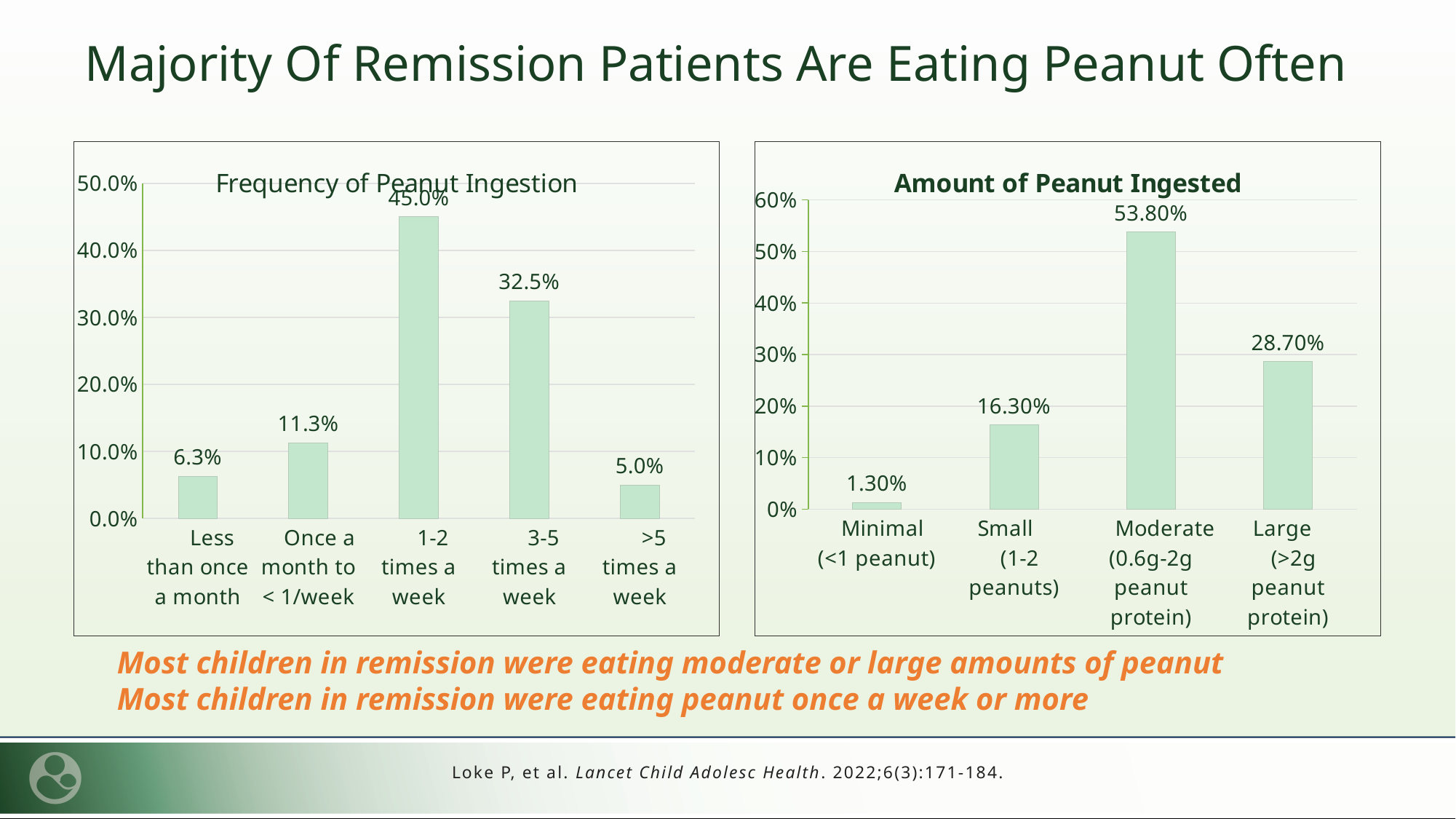
In the 'Amount of Peanut Ingested' chart, which category has the highest value? Moderate (0.6g-2g peanut protein) In the 'Frequency of Peanut Ingestion' chart, which category has the lowest value? >5 times a week In the 'Amount of Peanut Ingested' chart, what is the value for 'Small (1-2 peanuts)'? 16.30% What kind of chart is the 'Amount of Peanut Ingested' chart? Bar chart In the 'Amount of Peanut Ingested' chart, what is the value for 'Moderate (0.6g-2g peanut protein)'? 53.80% What is the title of the chart on the left side of the slide? Frequency of Peanut Ingestion In the 'Frequency of Peanut Ingestion' chart, what is the difference between '1-2 times a week' and '3-5 times a week'? 12.5% In the 'Frequency of Peanut Ingestion' chart, what is the value for 'Less than once a month'? 6.3% In the 'Frequency of Peanut Ingestion' chart, how many categories are shown? 5 In the 'Frequency of Peanut Ingestion' chart, what is the value for '1-2 times a week'? 45.0% In the 'Amount of Peanut Ingested' chart, which is larger: 'Large (>2g peanut protein)' or 'Small (1-2 peanuts)'? Large (>2g peanut protein) In the 'Amount of Peanut Ingested' chart, what is the difference between 'Moderate' and 'Large'? 25.10%